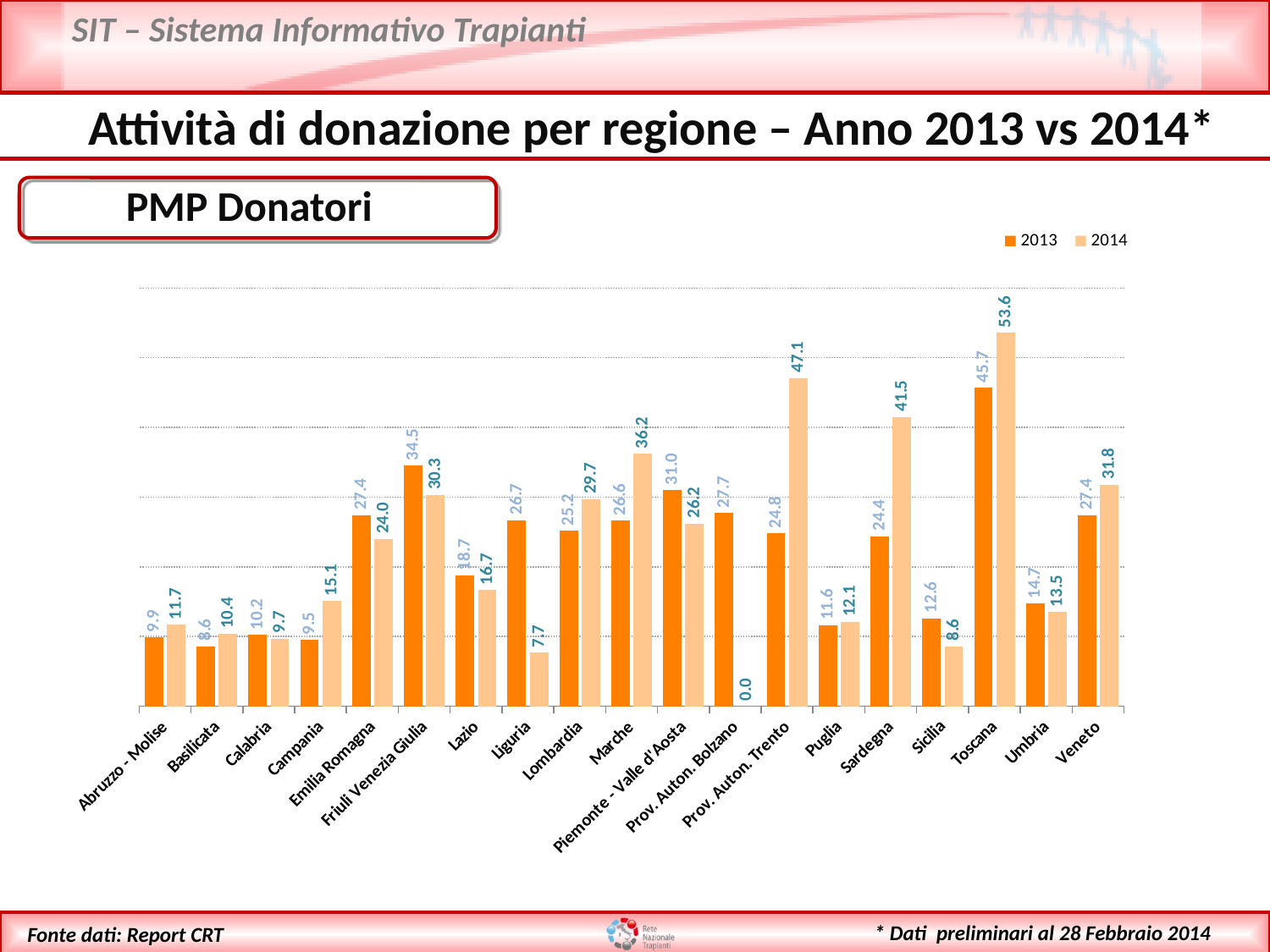
What is the 2014 value for Liguria? 7.7 What is the 2013 value for Prov. Auton. Trento? 24.8 How many regions are shown on the x axis? 19 Which region has the lowest 2014 value? Prov. Auton. Bolzano How many series does the legend list? 2 What is the 2014 value for Toscana? 53.6 Which region has the lowest 2013 value? Basilicata What kind of chart is shown on the slide? Bar chart Which region has the highest 2014 value? Toscana What is the difference between the 2014 and 2013 values for Toscana? 7.9 Which is larger for Sardegna, the 2013 value or the 2014 value? 2014 What is the difference between the 2014 and 2013 values for Prov. Auton. Trento? 22.3